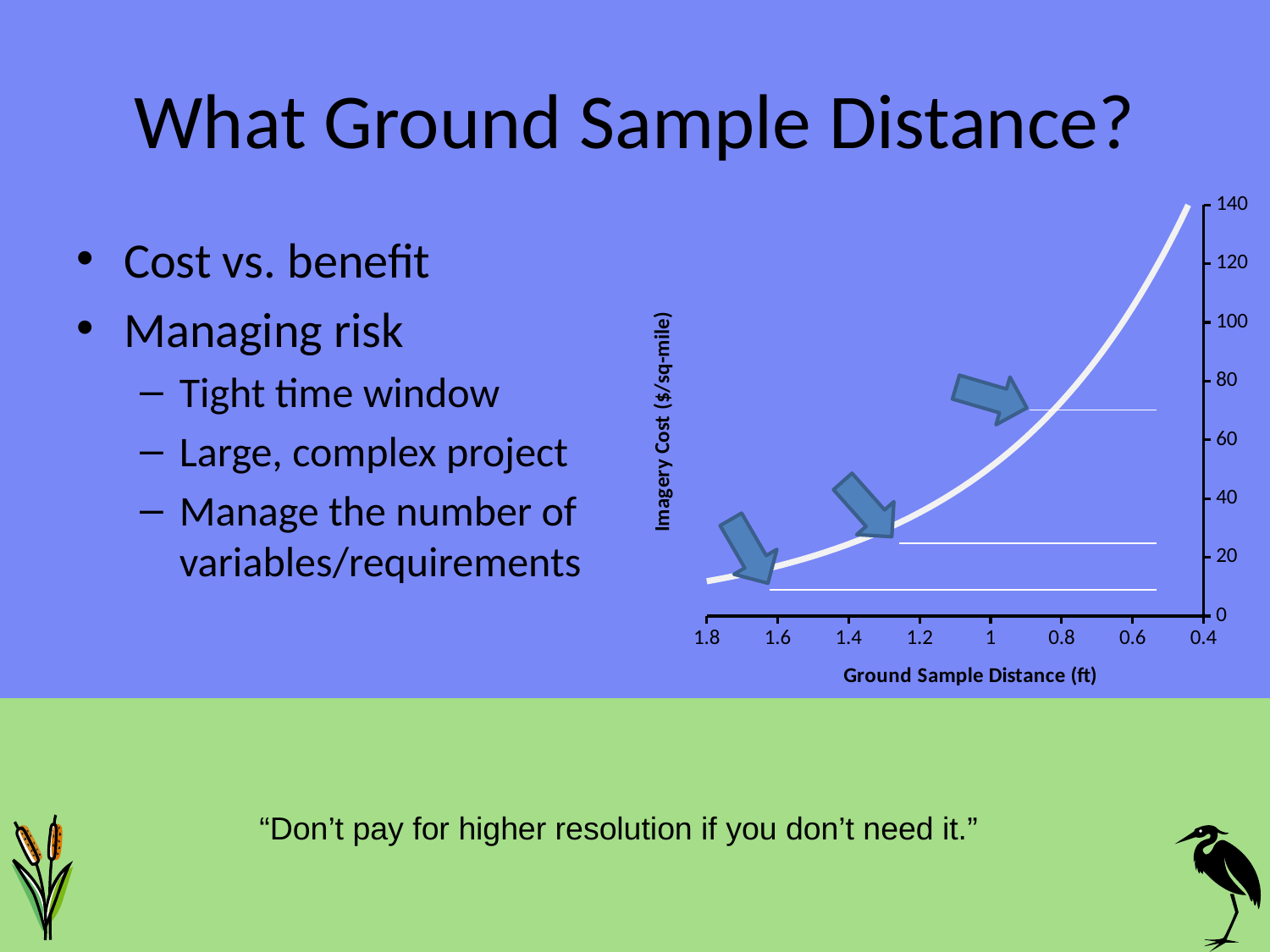
Is the imagery cost at a ground sample distance of 0.8 ft greater or less than 100? less Does the imagery cost rise or fall as you move from left to right along the x axis (from 1.8 ft toward 0.4 ft)? rise Is the imagery cost at a ground sample distance of 1 ft greater or less than 20? greater What is the highest value shown on the chart's y axis? 140 How many lines (data series) are plotted on the chart? 1 What is the title of the chart's y axis? Imagery Cost ($/sq-mile) What is the title of the chart's x axis? Ground Sample Distance (ft) Is the imagery cost at a ground sample distance of 0.6 ft greater or less than 80? greater Which ground sample distance has the higher imagery cost, 0.6 ft or 1.2 ft? 0.6 ft What kind of chart is shown on the slide? line chart